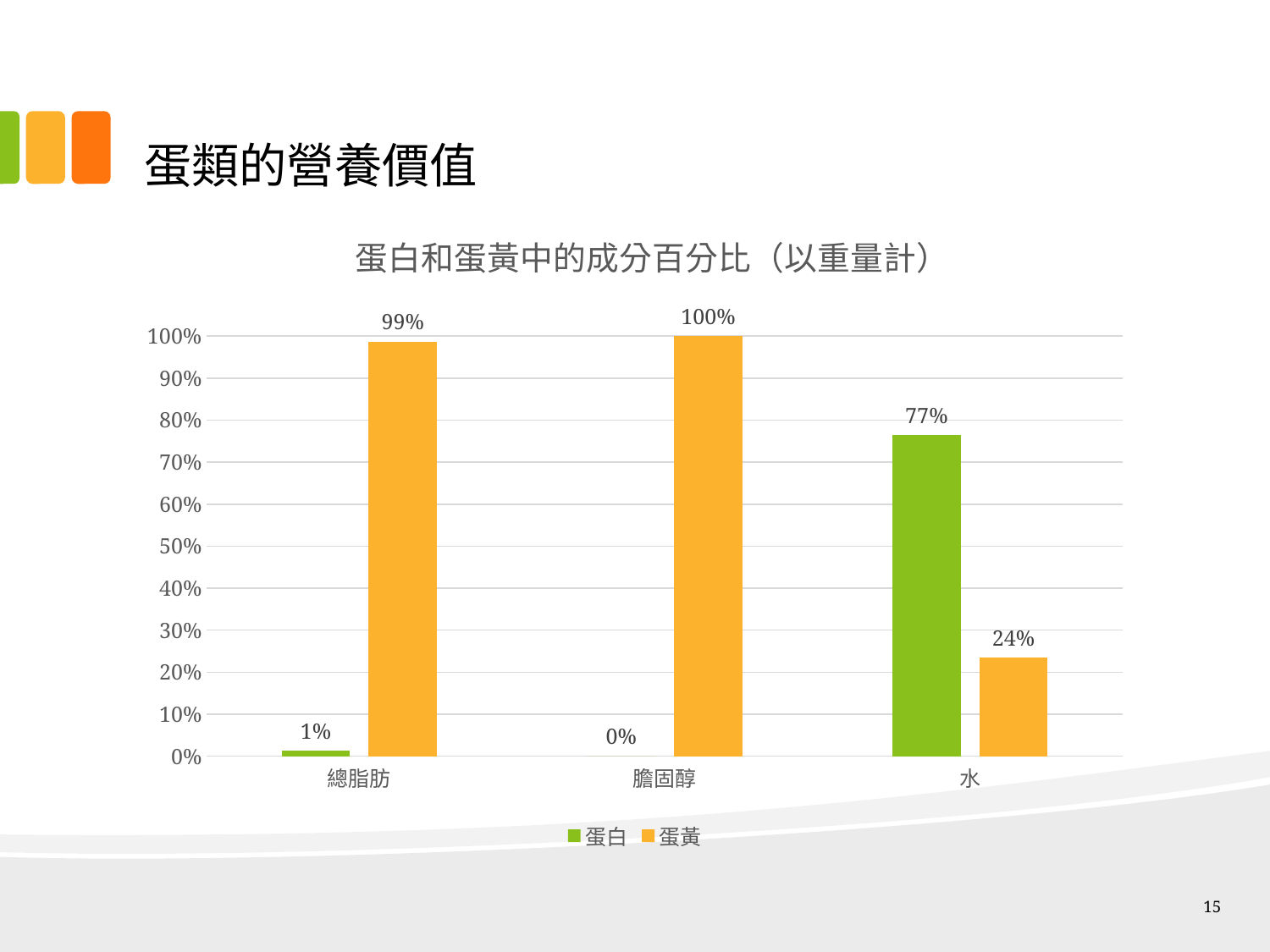
What is the difference between the 蛋白 and 蛋黃 values in the 水 category? 53% What is the value for 蛋黃 in the 水 category? 24% In the 總脂肪 category, which is larger, 蛋白 or 蛋黃? 蛋黃 What is the value for 蛋黃 in the 總脂肪 category? 99% How many categories are shown on the x axis? 3 In which category does 蛋白 have its lowest value? 膽固醇 What is the value for 蛋白 in the 水 category? 77% How many series does the legend list? 2 What is the value for 蛋白 in the 膽固醇 category? 0% What is the title of the chart? 蛋白和蛋黃中的成分百分比（以重量計） In which category does 蛋黃 have its highest value? 膽固醇 What kind of chart is shown on the slide? Bar chart